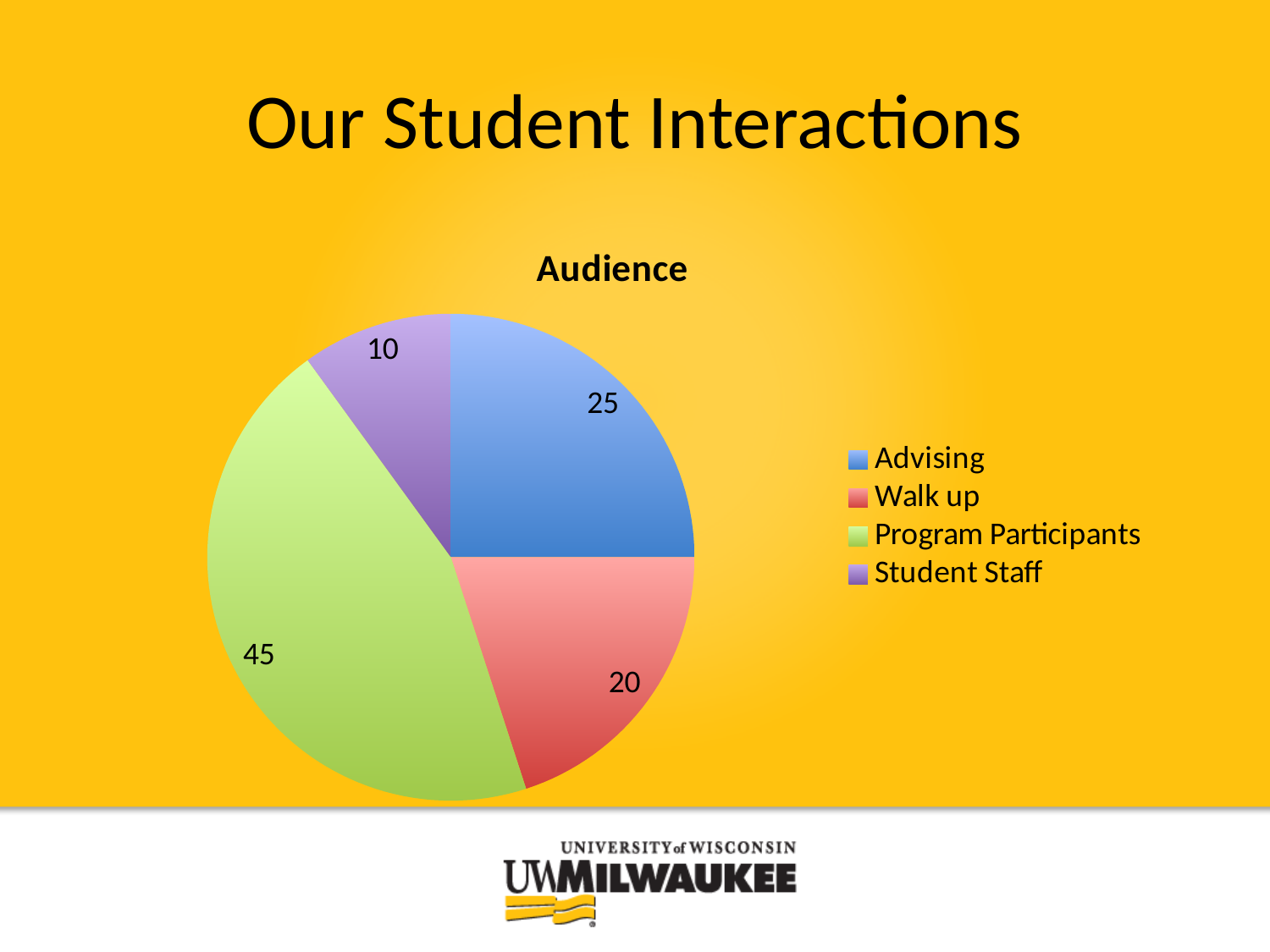
What is the value for Advising? 25 What share of the pie does Program Participants represent? 45% Which category has the smallest slice? Student Staff What kind of chart is shown on the slide? Pie chart What is the difference between the values for Program Participants and Advising? 20 What is the value for Program Participants? 45 Which category has the largest slice? Program Participants What is the value for Walk up? 20 What is the title of the chart? Audience What is the value for Student Staff? 10 Which is larger, the value for Advising or the value for Walk up? Advising How many categories does the pie chart show? 4